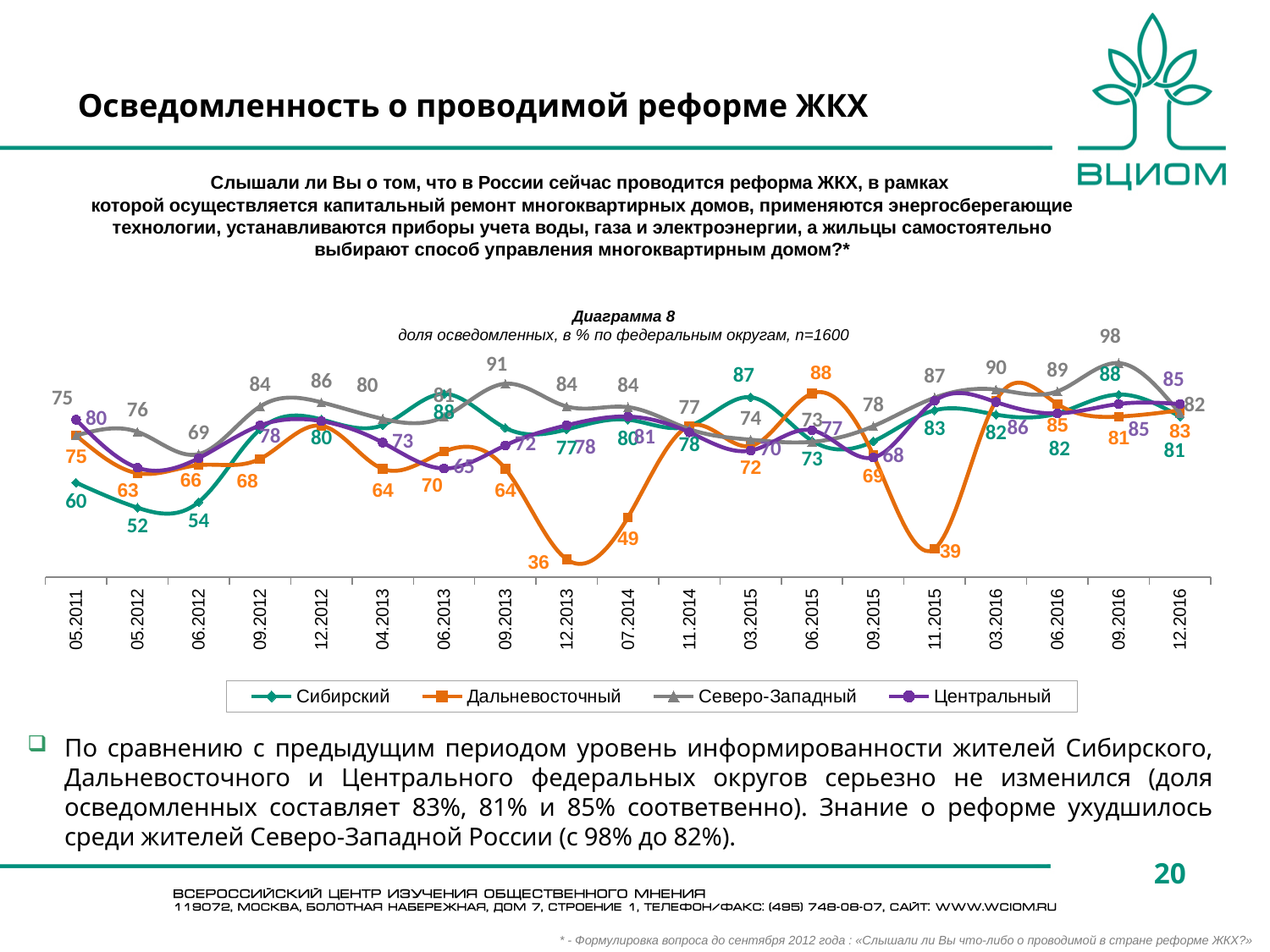
What is the value for Северо-Западный in 09.2016? 98 What is the value for Дальневосточный in 12.2013? 36 How many series does the chart legend list? 4 How many time points are shown on the x axis of the chart? 19 What is the value for Дальневосточный in 11.2015? 39 At which time point does Дальневосточный have its lowest value? 12.2013 At which time point does Северо-Западный reach its highest value? 09.2016 In 12.2013, which is larger: the value for Северо-Западный or for Дальневосточный? Северо-Западный What is the value for Сибирский in 05.2012? 52 What kind of chart is shown on the slide? line chart By how much did the value for Северо-Западный fall from 09.2016 to 12.2016? 16 What is the value for Центральный in 12.2016? 85